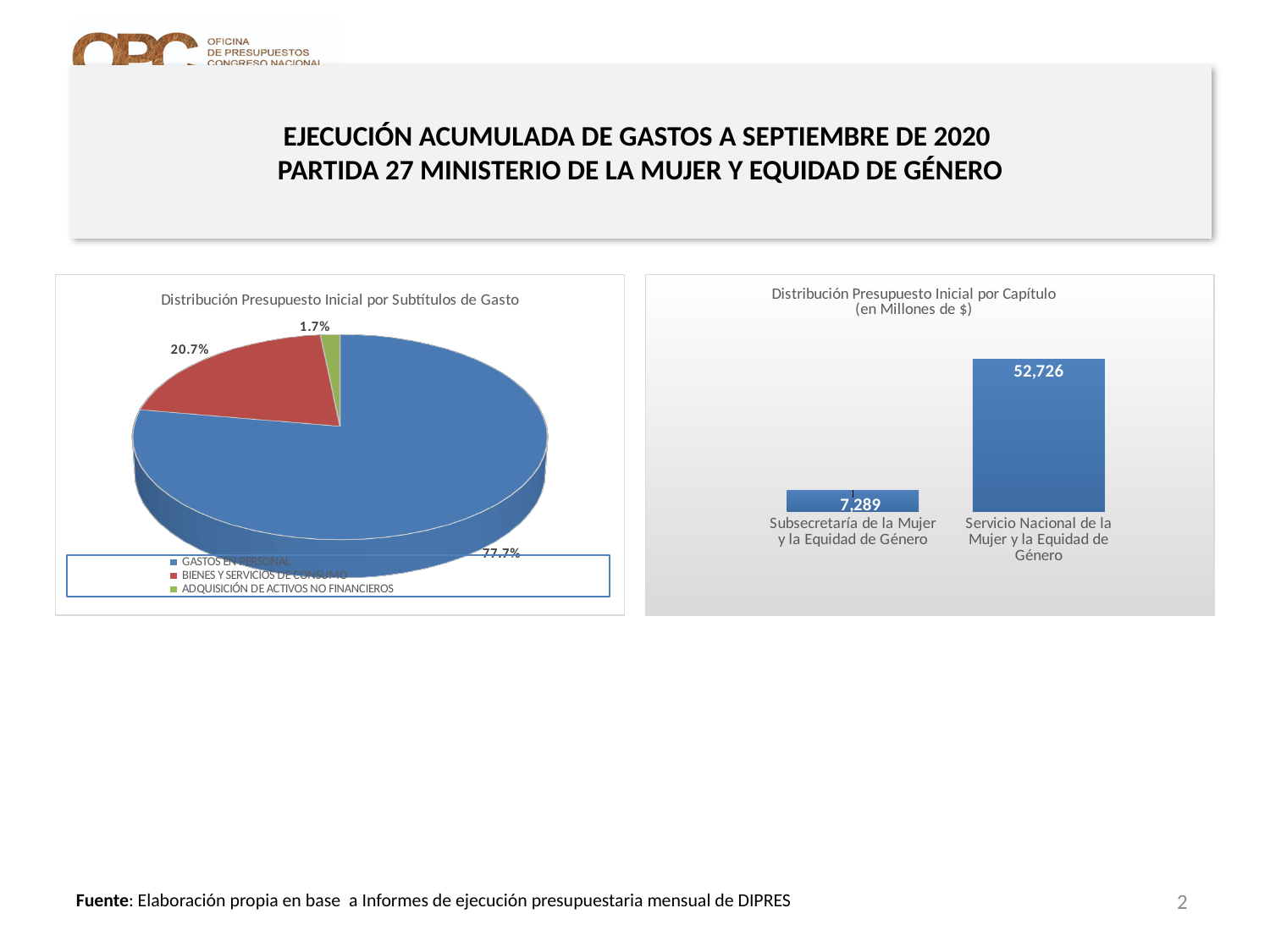
How many categories does the legend of 'Distribución Presupuesto Inicial por Subtítulos de Gasto' list? 3 In the chart 'Distribución Presupuesto Inicial por Capítulo', what is the value for Servicio Nacional de la Mujer y la Equidad de Género? 52,726 In the chart 'Distribución Presupuesto Inicial por Subtítulos de Gasto', what share does ADQUISICIÓN DE ACTIVOS NO FINANCIEROS have? 1.7% In the chart 'Distribución Presupuesto Inicial por Subtítulos de Gasto', which category has the smallest slice? ADQUISICIÓN DE ACTIVOS NO FINANCIEROS What kind of chart is 'Distribución Presupuesto Inicial por Subtítulos de Gasto'? Pie chart In the chart 'Distribución Presupuesto Inicial por Capítulo', what is the value for Subsecretaría de la Mujer y la Equidad de Género? 7,289 In the chart 'Distribución Presupuesto Inicial por Capítulo', which category has the higher value? Servicio Nacional de la Mujer y la Equidad de Género In the chart 'Distribución Presupuesto Inicial por Subtítulos de Gasto', what share does GASTOS EN PERSONAL have? 77.7% In the chart 'Distribución Presupuesto Inicial por Subtítulos de Gasto', what share does BIENES Y SERVICIOS DE CONSUMO have? 20.7% What kind of chart is 'Distribución Presupuesto Inicial por Capítulo'? Bar chart In the chart 'Distribución Presupuesto Inicial por Subtítulos de Gasto', which category has the largest slice? GASTOS EN PERSONAL In the chart 'Distribución Presupuesto Inicial por Capítulo', what is the difference between Servicio Nacional de la Mujer y la Equidad de Género and Subsecretaría de la Mujer y la Equidad de Género? 45,437